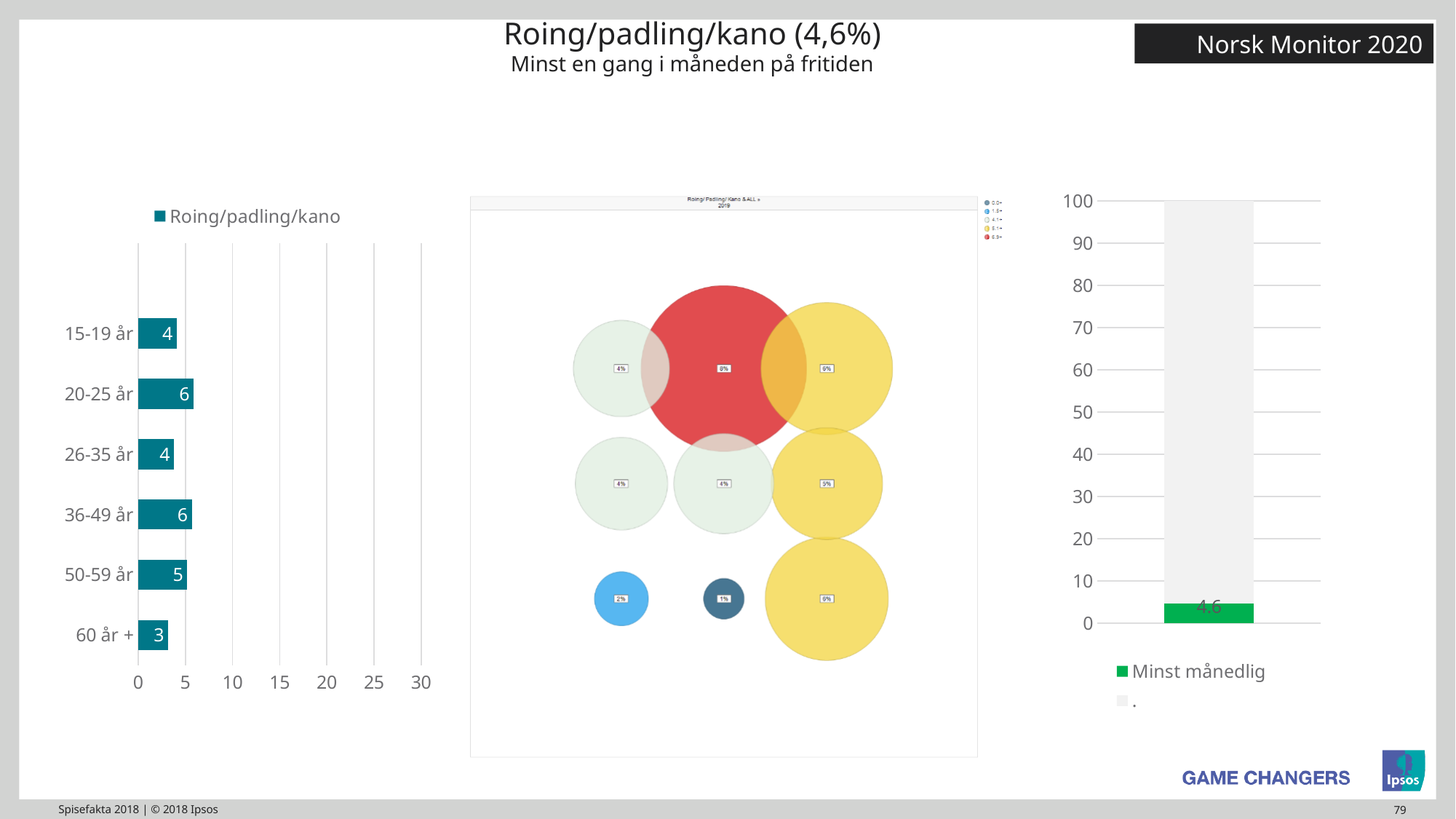
In the left bar chart, what is the series name shown in the legend? Roing/padling/kano In the left bar chart, what is the difference between the values for 36-49 år and 15-19 år? 2 In the left bar chart, what is the value for 20-25 år? 6 In the left bar chart, what is the value for 50-59 år? 5 In the left bar chart, how many age groups are shown? 6 In the right bar chart, how many series does the legend list? 2 In the left bar chart, which age group has the lowest value? 60 år + What kind of chart is the left chart on the slide? Bar chart In the left bar chart, what is the value for 60 år +? 3 In the right bar chart, what is the value for Minst månedlig? 4.6 In the right bar chart, is the value for Minst månedlig greater or less than 10? less In the left bar chart, which is larger, the value for 50-59 år or the value for 26-35 år? 50-59 år